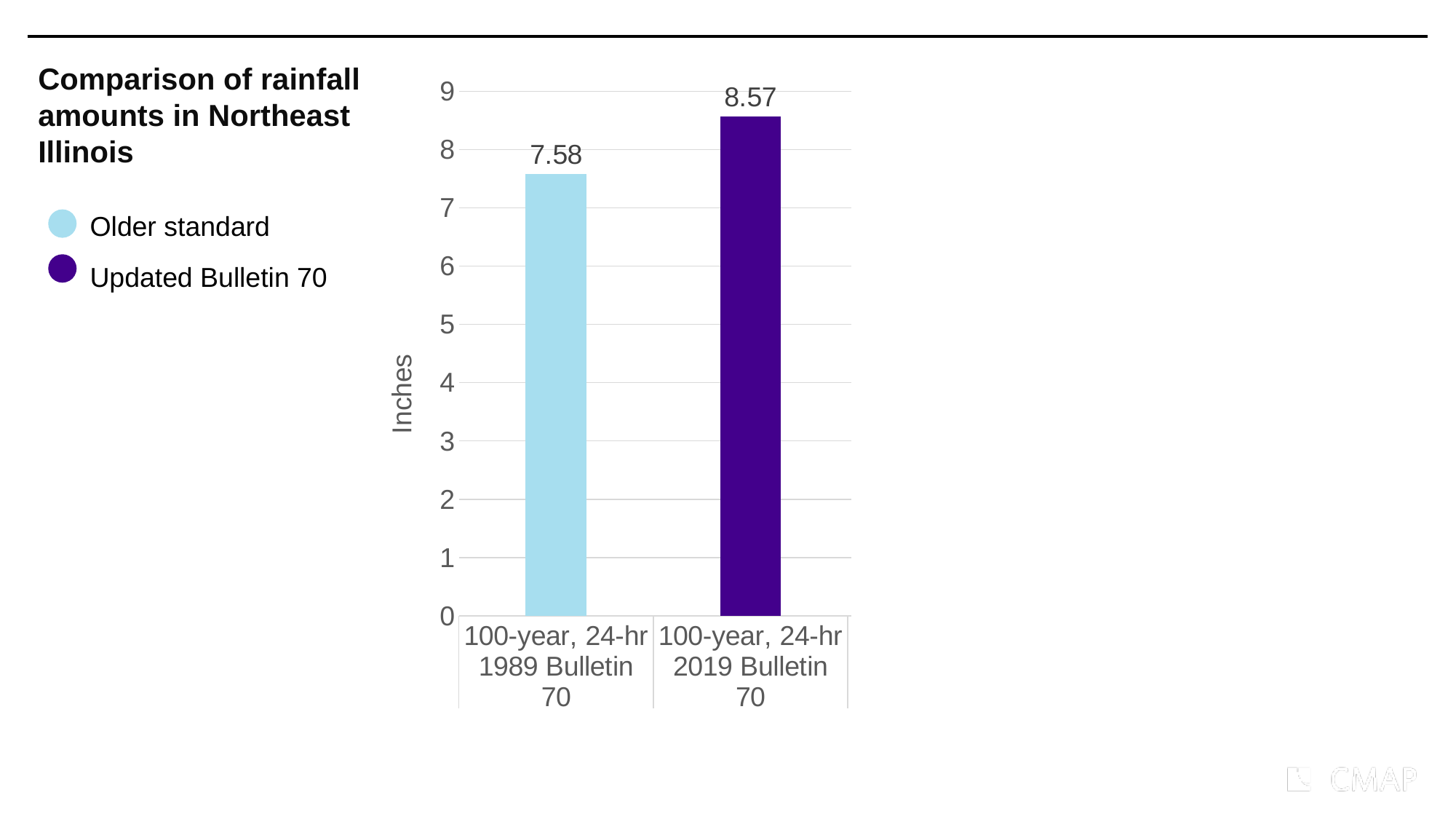
Is the value for the Updated Bulletin 70 larger than the value for the Older standard? Yes What is the label on the y axis? Inches What is the rainfall amount for 100-year, 24-hr 2019 Bulletin 70? 8.57 What is the title of the chart? Comparison of rainfall amounts in Northeast Illinois What kind of chart is shown on the slide? Bar chart What is the rainfall amount for 100-year, 24-hr 1989 Bulletin 70? 7.58 Which category has the lower rainfall amount? 100-year, 24-hr 1989 Bulletin 70 Is the value for 100-year, 24-hr 1989 Bulletin 70 greater or less than 8? less What is the difference in inches between the 2019 Bulletin 70 value and the 1989 Bulletin 70 value? 0.99 How many categories are shown on the x axis? 2 How many entries does the legend list? 2 Which category has the higher rainfall amount? 100-year, 24-hr 2019 Bulletin 70